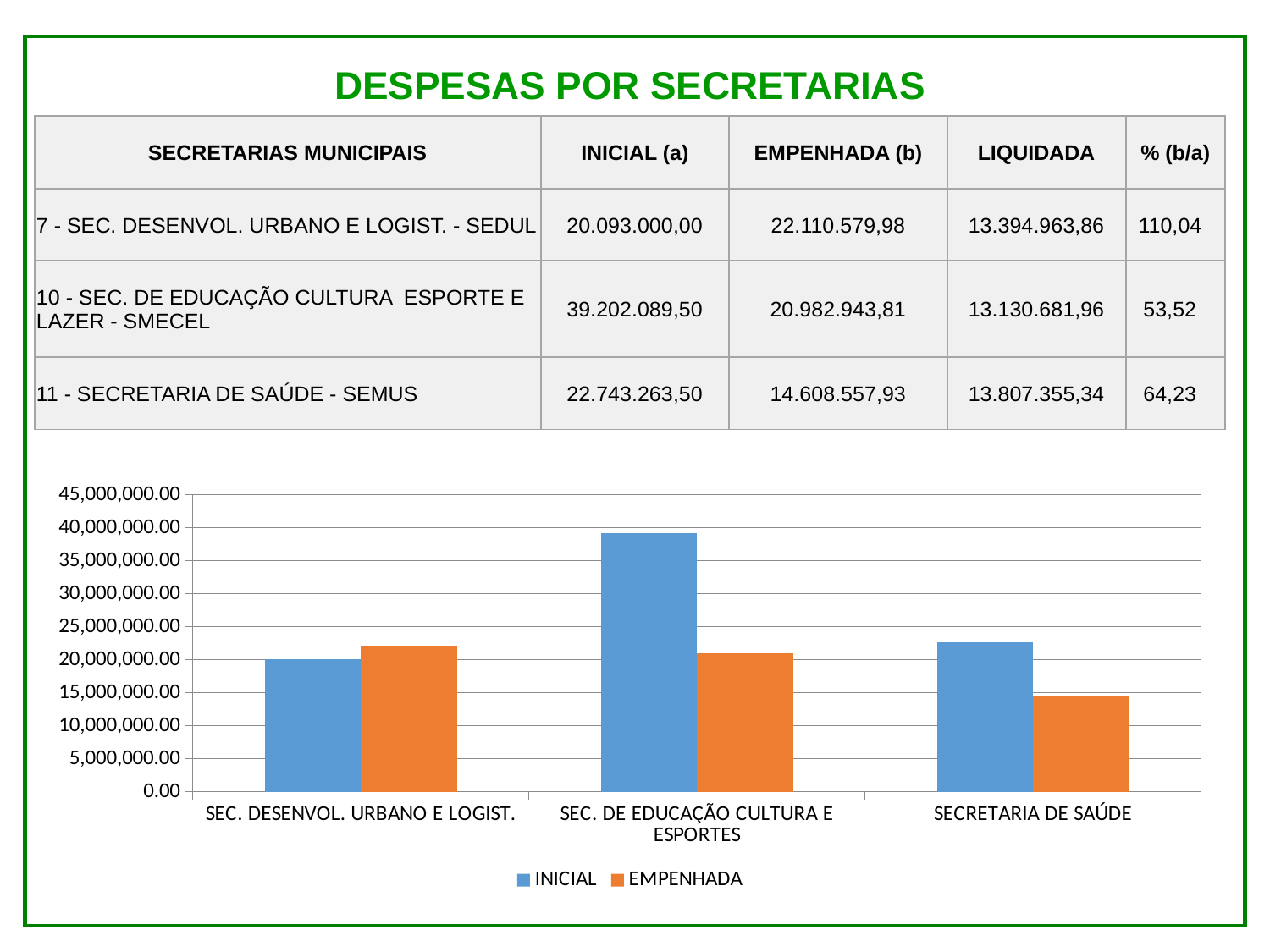
Which category has the highest INICIAL value in the chart? SEC. DE EDUCAÇÃO CULTURA E ESPORTES How many categories are shown on the x axis of the chart? 3 What are the two entries in the chart legend? INICIAL and EMPENHADA What colour are the EMPENHADA bars in the chart? orange What kind of chart is shown on the slide? bar chart How many series does the chart legend list? 2 For SEC. DESENVOL. URBANO E LOGIST., which is larger in the chart: INICIAL or EMPENHADA? EMPENHADA Is the EMPENHADA value for SECRETARIA DE SAÚDE greater or less than 20,000,000.00? less Is the INICIAL value for SECRETARIA DE SAÚDE greater or less than 20,000,000.00? greater Is the INICIAL value for SEC. DE EDUCAÇÃO CULTURA E ESPORTES greater or less than 35,000,000.00? greater For SECRETARIA DE SAÚDE, which is larger in the chart: INICIAL or EMPENHADA? INICIAL Which category has the lowest EMPENHADA value in the chart? SECRETARIA DE SAÚDE